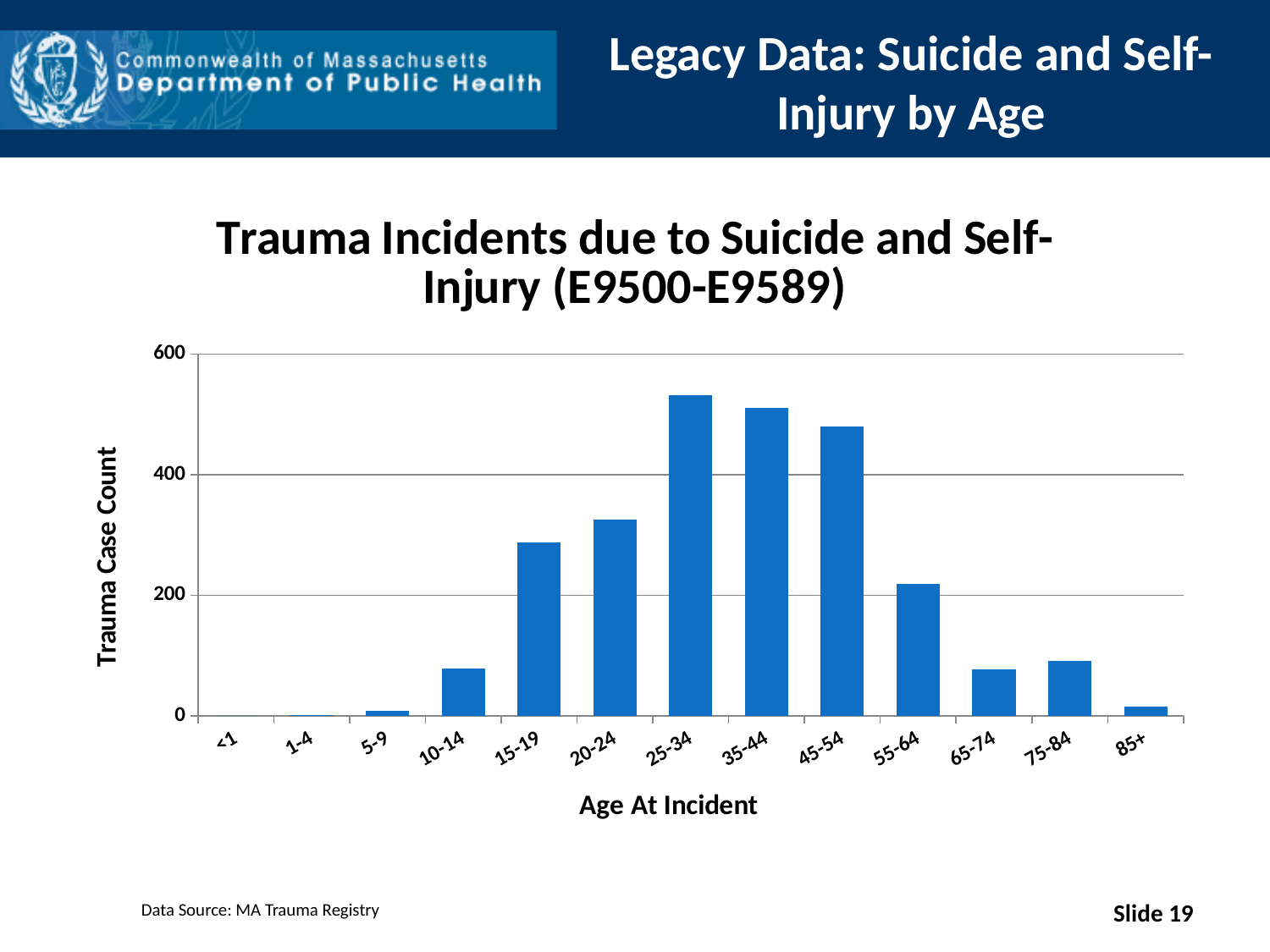
Which has a higher trauma case count, the 55-64 age group or the 65-74 age group? 55-64 What is the label of the vertical axis? Trauma Case Count Which age group has the highest trauma case count? 25-34 Is the value for the 20-24 age group greater or less than 200? greater What kind of chart is shown on the slide? Bar chart Which has a higher trauma case count, the 15-19 age group or the 20-24 age group? 20-24 What is the title of the chart? Trauma Incidents due to Suicide and Self-Injury (E9500-E9589) Is the value for the 25-34 age group greater or less than 400? greater Is the value for the 85+ age group greater or less than 200? less How many age categories are shown on the x axis? 13 Do the trauma case counts rise or fall from the 25-34 age group to the 85+ age group? fall